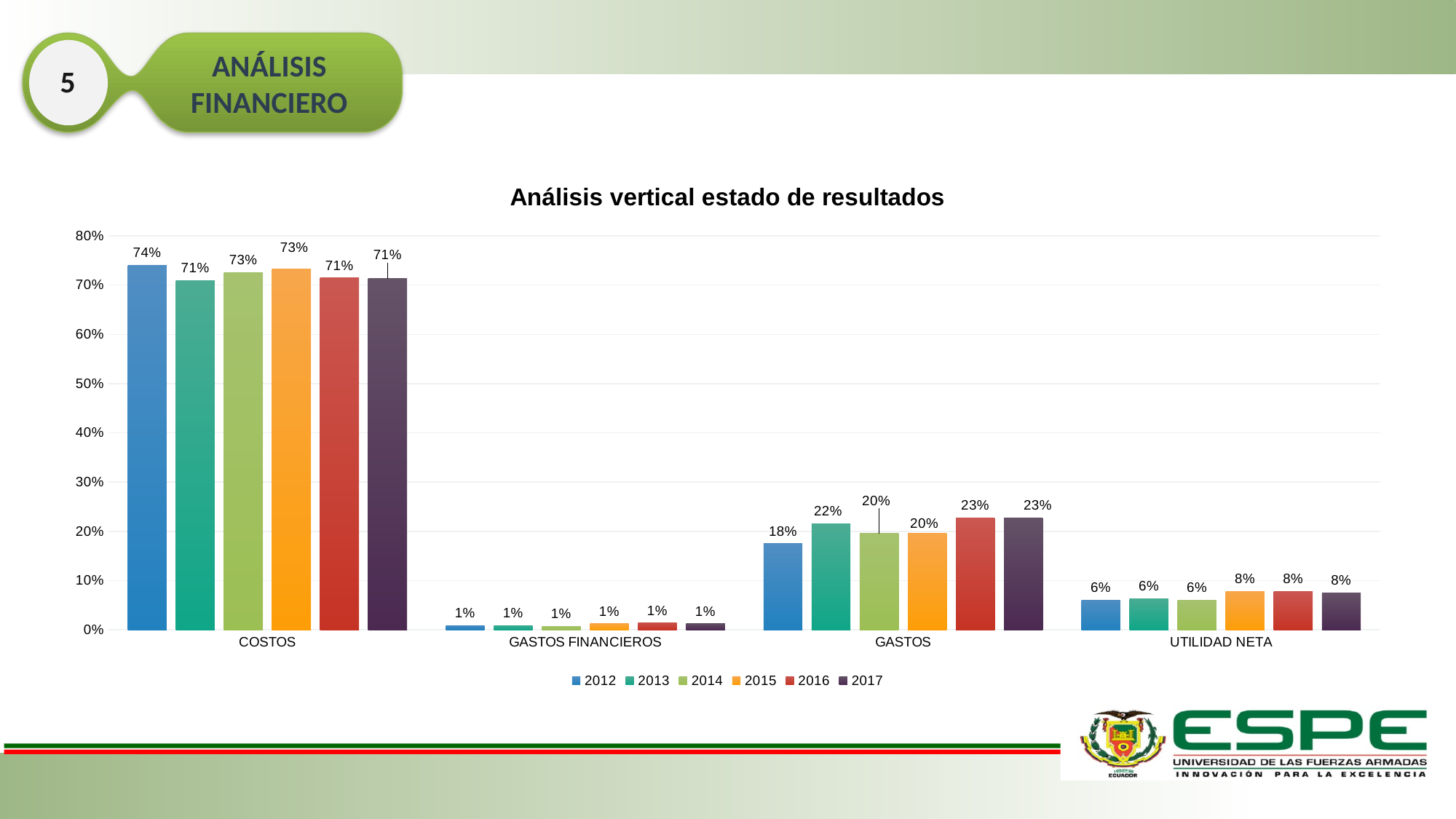
Which is larger: GASTOS in 2012 or GASTOS in 2017? GASTOS in 2017 What is the value for COSTOS in 2012? 74% What is the value for UTILIDAD NETA in 2017? 8% Which category has the lowest value in 2014? GASTOS FINANCIEROS How many series does the legend list? 6 What kind of chart is shown on the slide? Bar chart What is the value for GASTOS in 2013? 22% What is the value for GASTOS FINANCIEROS in 2015? 1% Which category has the highest value in 2016? COSTOS How many categories are shown on the x axis? 4 What is the title of the chart? Análisis vertical estado de resultados What is the difference between the COSTOS value in 2012 and the COSTOS value in 2013? 3%